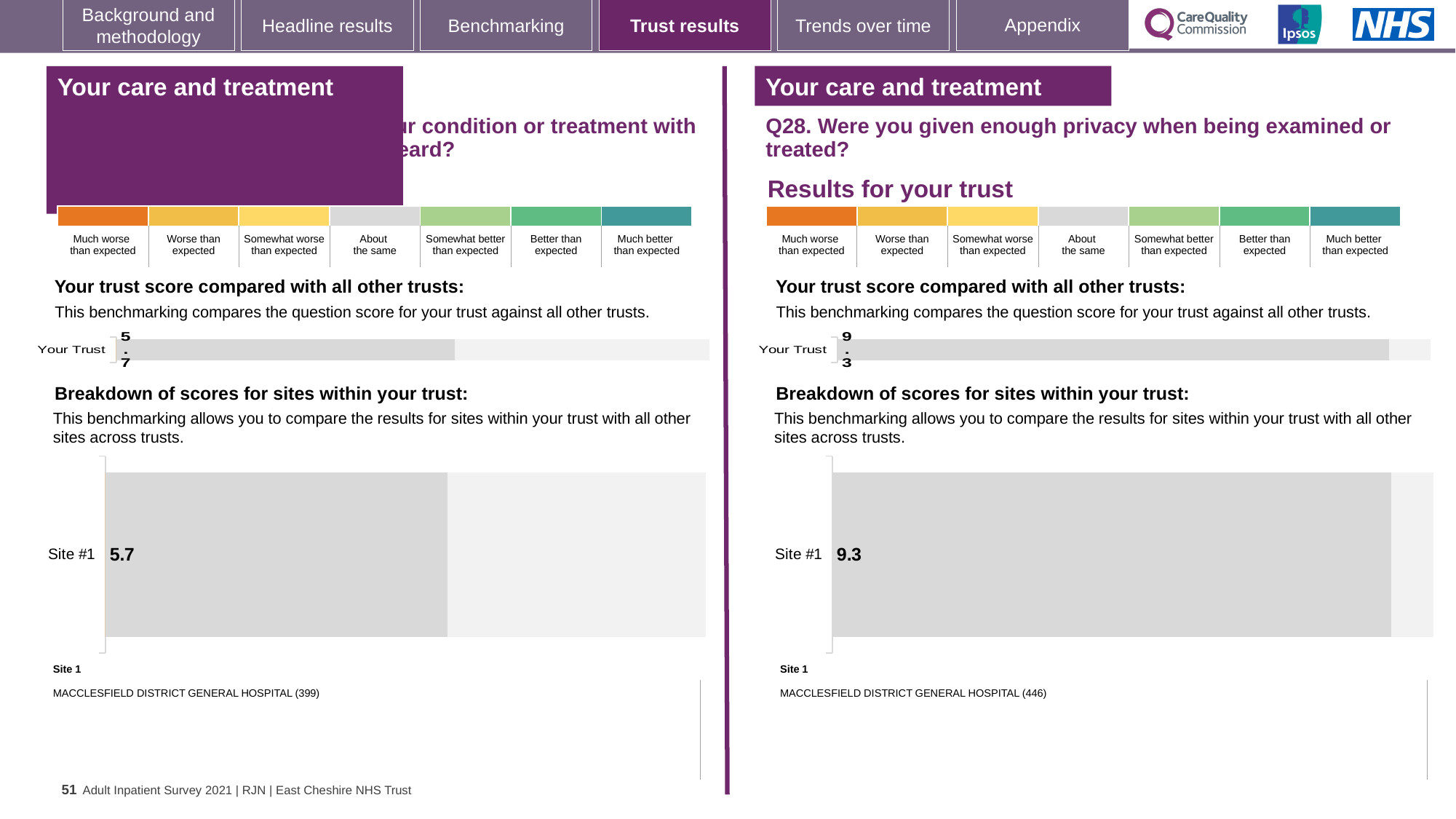
What type of chart is used to show the Site #1 score on the right-hand side of the slide? Bar chart On the right-hand chart for Q28 (privacy when being examined or treated), what is the score shown for Your Trust? 9.3 How many sites are shown in the right-hand 'Breakdown of scores for sites within your trust' chart? 1 Which is larger: the Your Trust score on the left-hand chart or the Your Trust score on the right-hand Q28 chart? Right-hand Q28 chart (9.3) On the left-hand site breakdown chart, what is the score for Site #1? 5.7 On the right-hand site breakdown chart for Q28, what is the score for Site #1? 9.3 What is the difference between the Site #1 score on the right-hand Q28 chart and the Site #1 score on the left-hand chart? 3.6 Which hospital is listed as Site 1 beneath the right-hand Q28 site breakdown chart? MACCLESFIELD DISTRICT GENERAL HOSPITAL (446) What is the number in brackets after Macclesfield District General Hospital beneath the left-hand site breakdown chart? 399 On the left-hand 'Your trust score compared with all other trusts' chart, what is the score shown for Your Trust? 5.7 How many sites are shown in the left-hand 'Breakdown of scores for sites within your trust' chart? 1